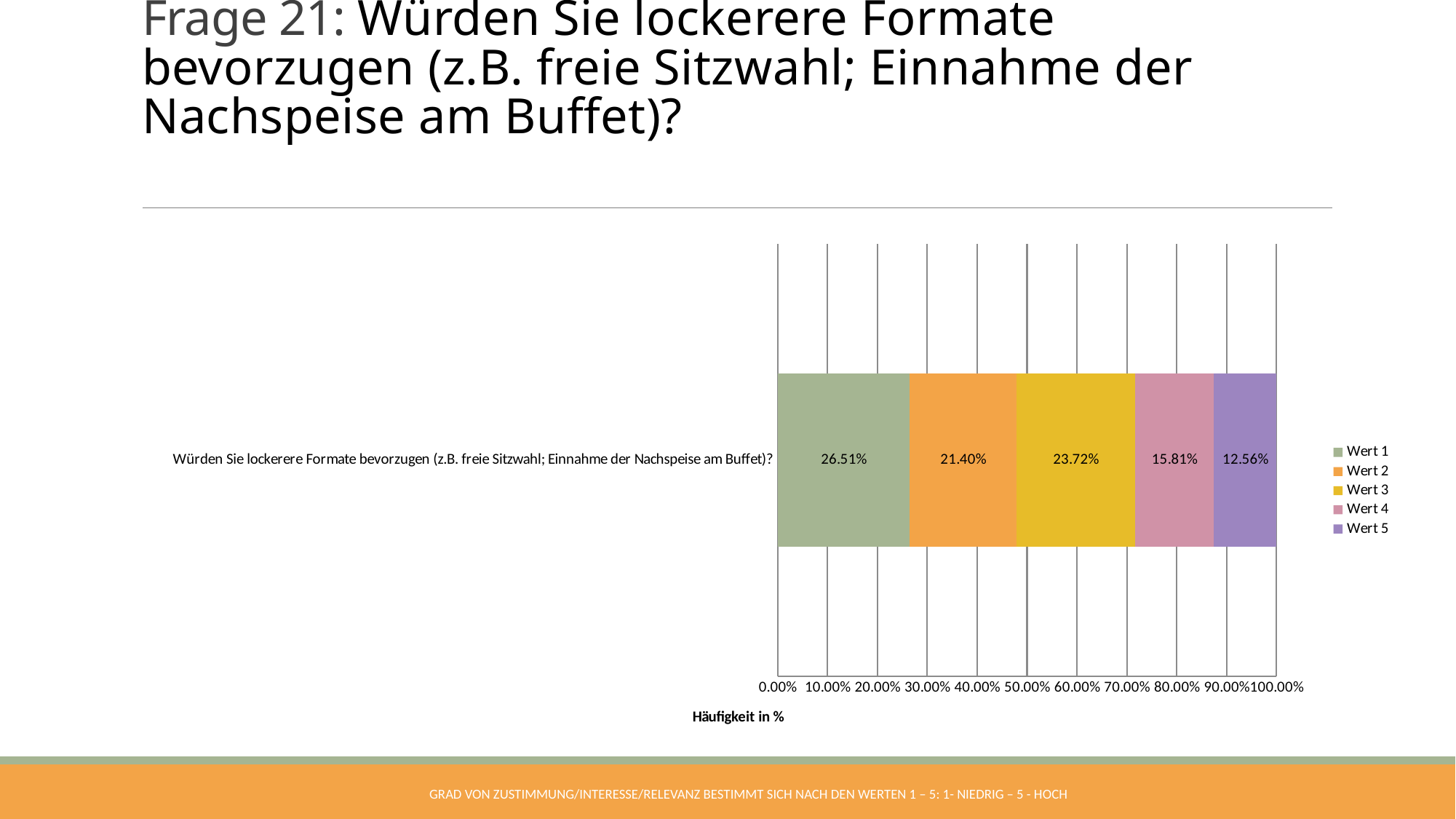
Which series has the lowest value? Wert 5 What is the label of the x axis? Häufigkeit in % What is the difference between the values for Wert 1 and Wert 2? 5.11% Which is larger, the value for Wert 2 or the value for Wert 3? Wert 3 What is the value for Wert 3? 23.72% What is the value for Wert 1? 26.51% Which series has the highest value? Wert 1 What is the total of the stacked bar? 100.00% What is the value for Wert 5? 12.56% What is the difference between the values for Wert 4 and Wert 5? 3.25% How many series does the legend list? 5 What kind of chart is shown on the slide? Stacked bar chart